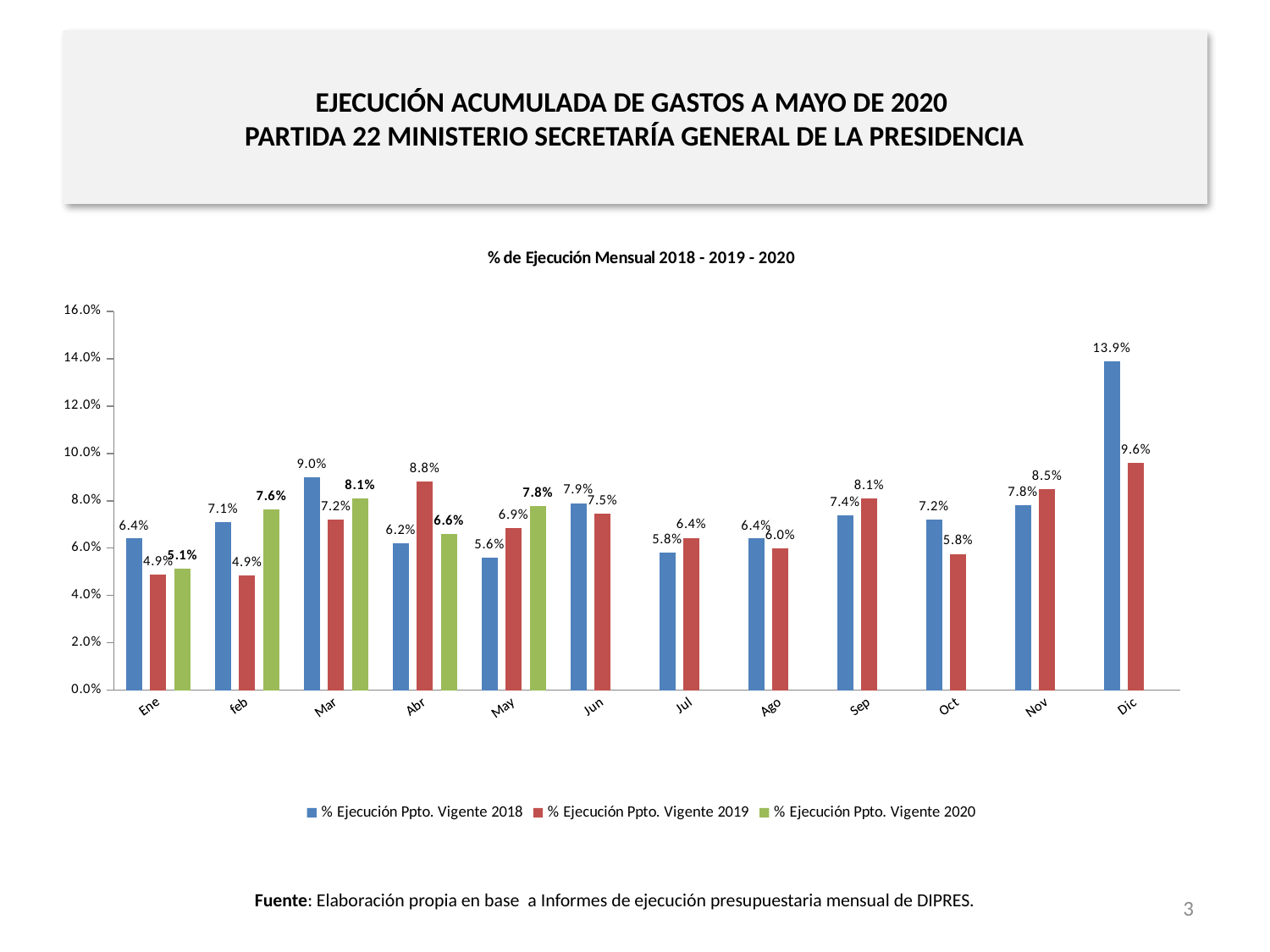
What is the title of the chart? % de Ejecución Mensual 2018 - 2019 - 2020 How many months are shown on the x axis? 12 What kind of chart is shown on the slide? Bar chart Which month has the lowest value in the % Ejecución Ppto. Vigente 2018 series? May How many series does the legend list? 3 What is the value for Abr in the % Ejecución Ppto. Vigente 2019 series? 8.8% Which is larger for Mar: the 2018 value or the 2020 value? 2018 (9.0%) What is the difference between the 2018 and 2019 values for Dic? 4.3% Which month has the lowest value in the % Ejecución Ppto. Vigente 2020 series? Ene What is the value for Dic in the % Ejecución Ppto. Vigente 2018 series? 13.9% What is the value for May in the % Ejecución Ppto. Vigente 2020 series? 7.8% Which month has the highest value in the % Ejecución Ppto. Vigente 2018 series? Dic